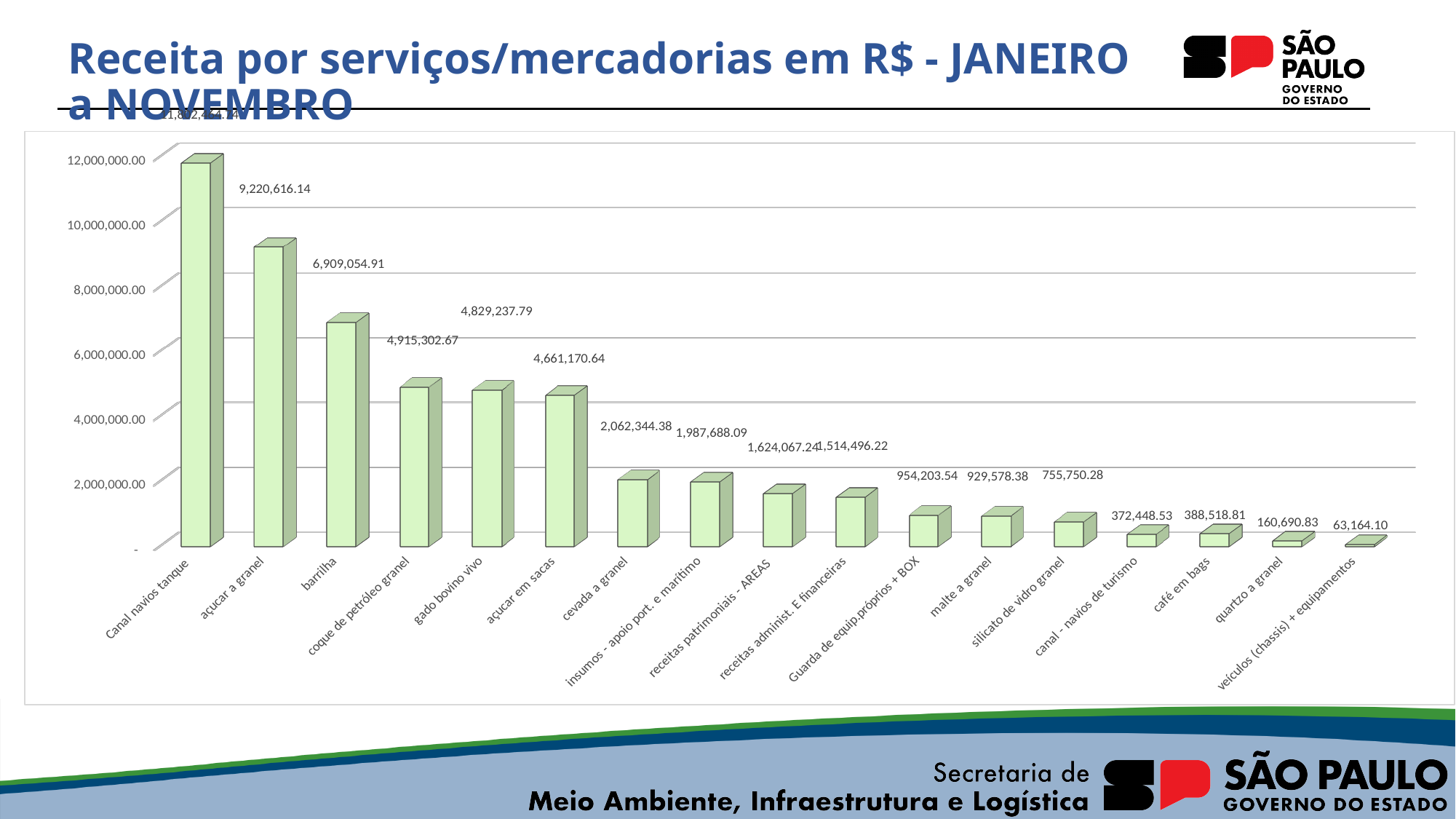
What is the value for gado bovino vivo? 4,829,237.79 What is the value for cevada a granel? 2,062,344.38 What is the difference between açucar a granel and barrilha? 2,311,561.23 Which category has the highest value? Canal navios tanque Which is larger, café em bags or canal - navios de turismo? café em bags What is the value for açucar a granel? 9,220,616.14 Which category has the lowest value? veículos (chassis) + equipamentos Is the value for Canal navios tanque greater or less than 10,000,000.00? greater What is the value for malte a granel? 929,578.38 What is the value for barrilha? 6,909,054.91 What kind of chart is this? bar chart How many categories are shown on the x axis? 17